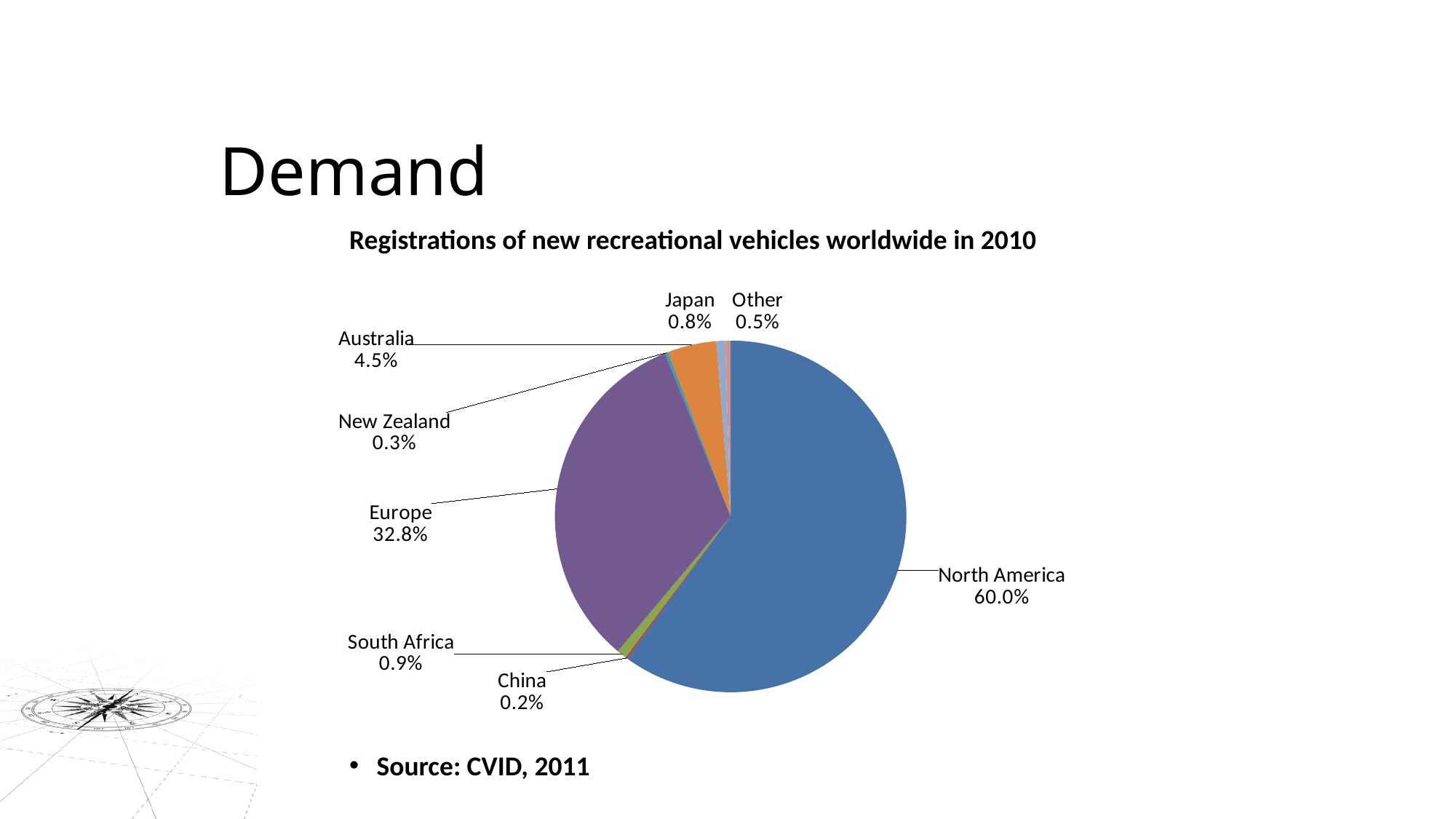
Which region has the smallest share of registrations? China Which has a larger share, Australia or Japan? Australia How many slices does the pie chart have? 8 What is the difference in percentage points between North America and Europe? 27.2 What is the share for South Africa? 0.9% What type of chart is shown on the slide? pie chart What share of registrations does Australia account for? 4.5% Which region has the largest share of registrations? North America What is the title of the chart? Registrations of new recreational vehicles worldwide in 2010 What share of registrations does Europe account for? 32.8% What share of registrations does North America account for? 60.0% What share of registrations does Japan account for? 0.8%